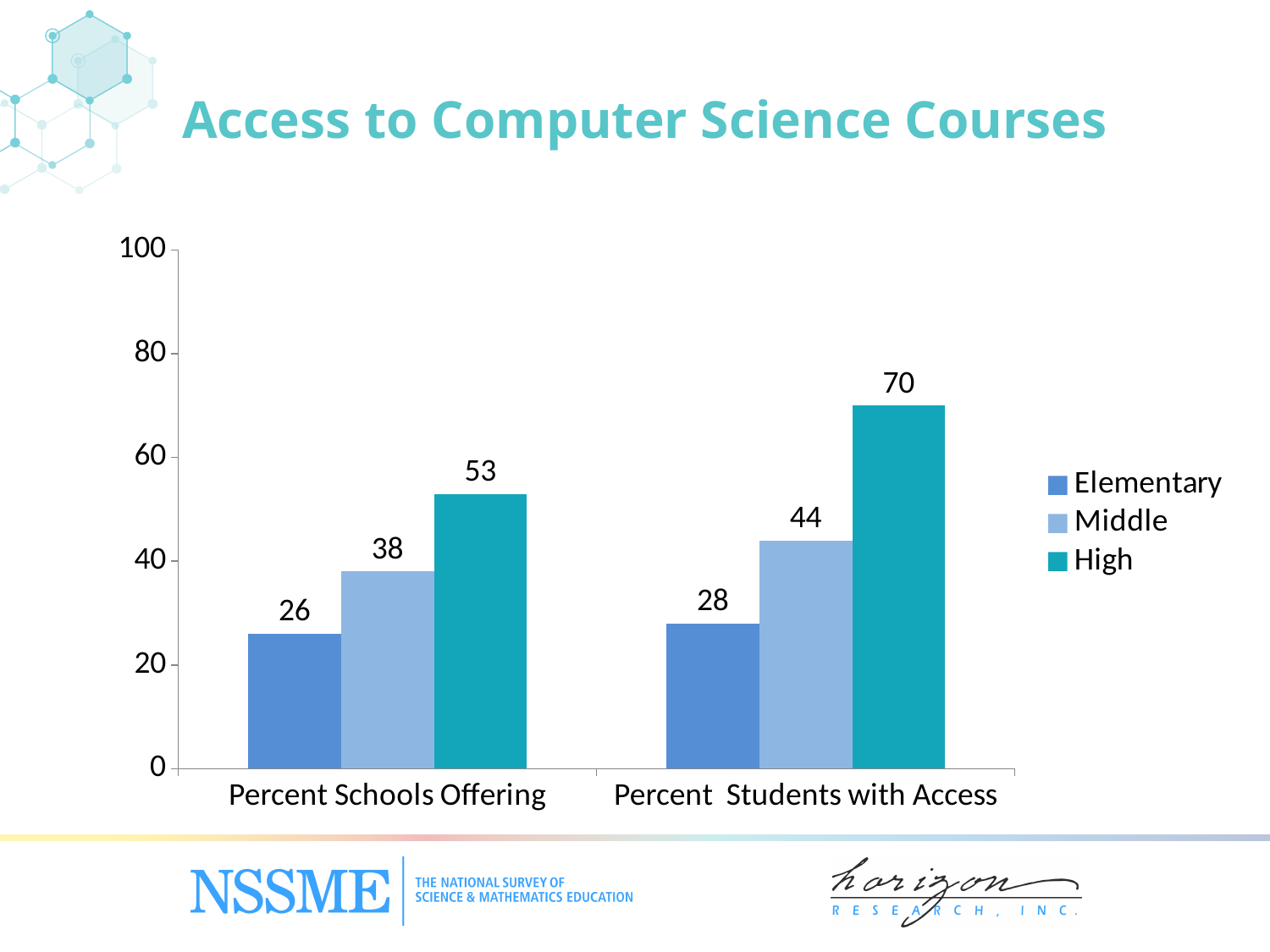
What is the title of the chart? Access to Computer Science Courses What kind of chart is shown on the slide? bar chart What is the value for High under Percent Schools Offering? 53 What is the value for Elementary under Percent Students with Access? 28 What is the difference between the High and Elementary values under Percent Students with Access? 42 Which series has the highest value under Percent Students with Access? High What is the value for Middle under Percent Schools Offering? 38 How many series does the legend list? 3 How many categories are shown on the x axis? 2 Which series has the lowest value under Percent Schools Offering? Elementary Is the value for High under Percent Students with Access greater or less than 60? greater Which is larger: the Middle value under Percent Schools Offering or the Middle value under Percent Students with Access? Percent Students with Access